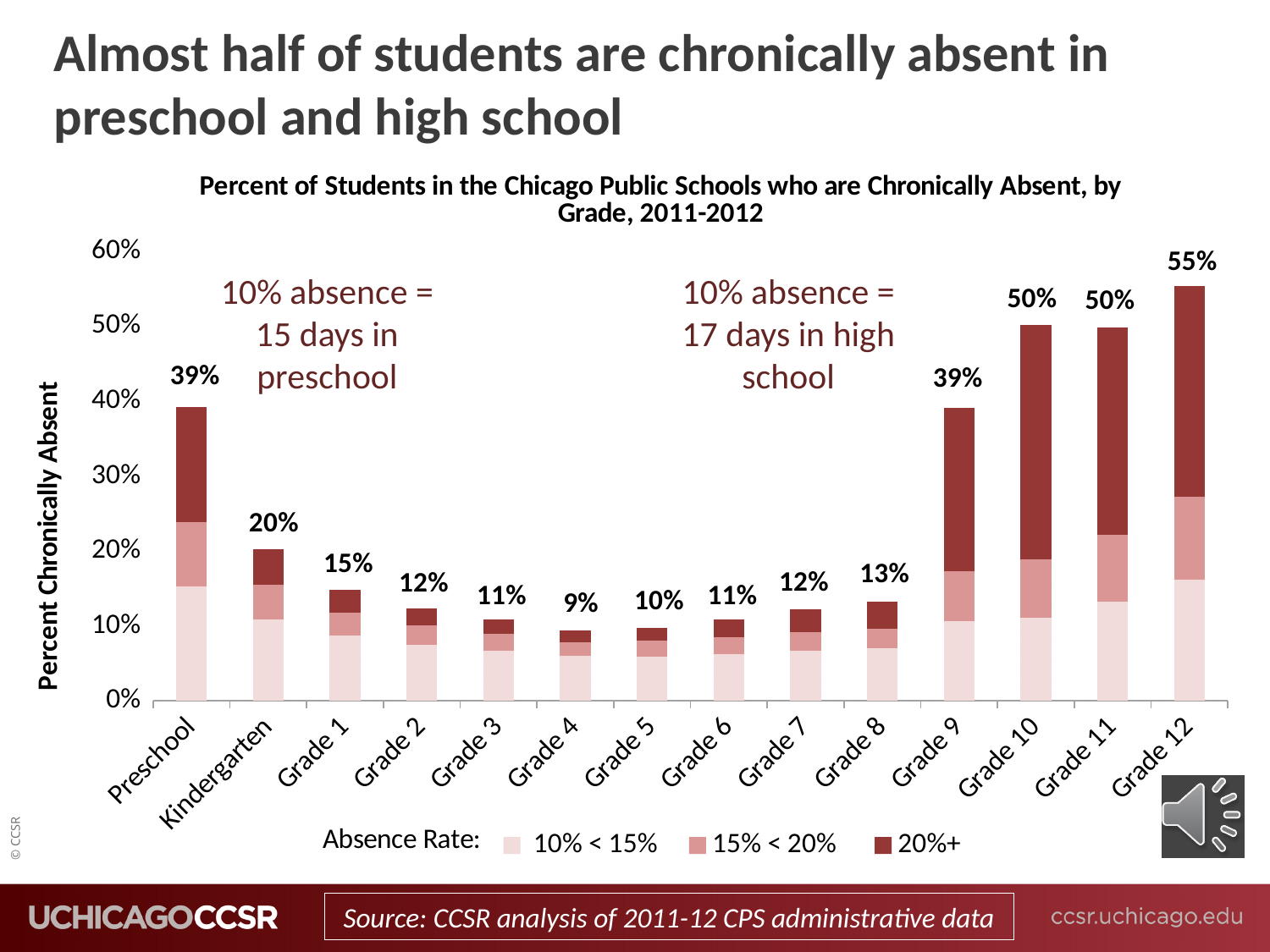
What is the total percent chronically absent for Preschool? 39% What is the total percent chronically absent for Kindergarten? 20% How many grade categories are shown on the x axis? 14 What kind of chart is shown on the slide? Stacked bar chart Which has a higher total percent chronically absent, Grade 8 or Grade 9? Grade 9 Which grade has the highest total percent chronically absent? Grade 12 Which grade has the lowest total percent chronically absent? Grade 4 What is the total percent chronically absent for Grade 10? 50% Do the total values rise or fall from Grade 9 to Grade 12? Rise Is the 20%+ absence rate segment for Grade 12 greater or less than 20%? greater How many absence rate series does the legend list? 3 What is the difference between the total for Grade 12 and the total for Preschool? 16%